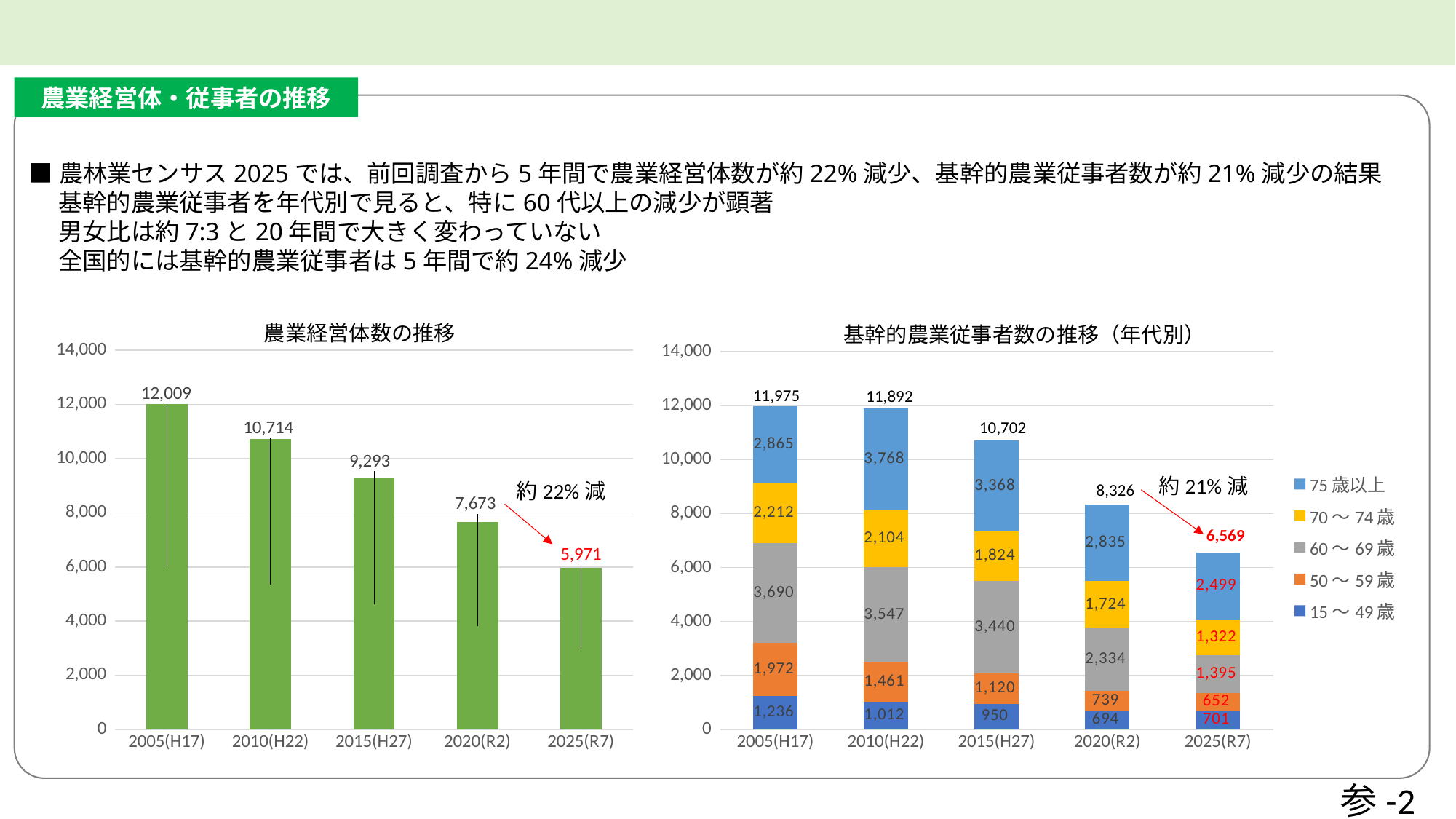
In the chart titled 基幹的農業従事者数の推移（年代別）, which is larger for 2010(H22): the 75歳以上 segment or the 60～69歳 segment? 75歳以上 In the chart titled 基幹的農業従事者数の推移（年代別）, which year has the highest total? 2005(H17) In the chart titled 農業経営体数の推移, do the values rise or fall from 2005(H17) to 2025(R7)? fall In the chart titled 農業経営体数の推移, what is the value for 2005(H17)? 12,009 In the chart titled 農業経営体数の推移, what is the difference between the 2020(R2) and 2025(R7) values? 1,702 In the chart titled 農業経営体数の推移, how many years are plotted? 5 In the chart titled 基幹的農業従事者数の推移（年代別）, what is the difference between the 15～49歳 values for 2005(H17) and 2025(R7)? 535 In the chart titled 基幹的農業従事者数の推移（年代別）, what is the total for the 2025(R7) bar? 6,569 In the chart titled 農業経営体数の推移, which year has the lowest value? 2025(R7) In the chart titled 基幹的農業従事者数の推移（年代別）, how many series does the legend list? 5 In the chart titled 基幹的農業従事者数の推移（年代別）, what is the value of the 60～69歳 segment for 2015(H27)? 3,440 What kind of chart is the chart titled 基幹的農業従事者数の推移（年代別）? stacked bar chart